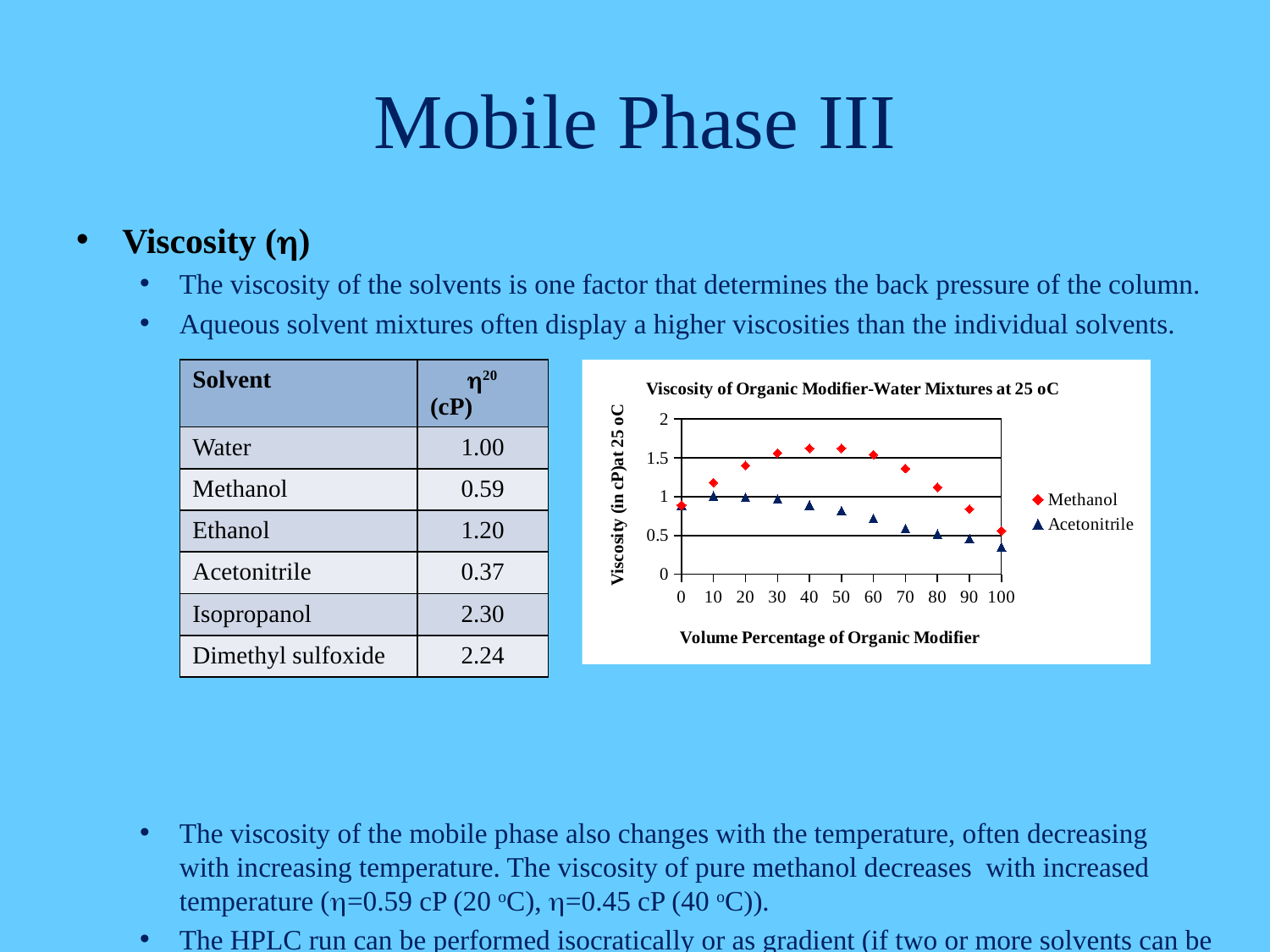
Is the Acetonitrile value at 100% organic modifier greater or less than 0.5? less Which two series are listed in the chart's legend? Methanol and Acetonitrile Is the Acetonitrile value at 60% organic modifier greater or less than 0.5? greater How many series does the chart's legend list? 2 How many data points are plotted for the Methanol series? 11 What is the title of the chart? Viscosity of Organic Modifier-Water Mixtures at 25 oC Is the Acetonitrile value at 40% organic modifier greater or less than 1? less What kind of chart is shown on the slide? scatter chart At 50% organic modifier, which series has the higher viscosity, Methanol or Acetonitrile? Methanol Does the Acetonitrile series rise or fall as the volume percentage increases from 20 to 100? fall